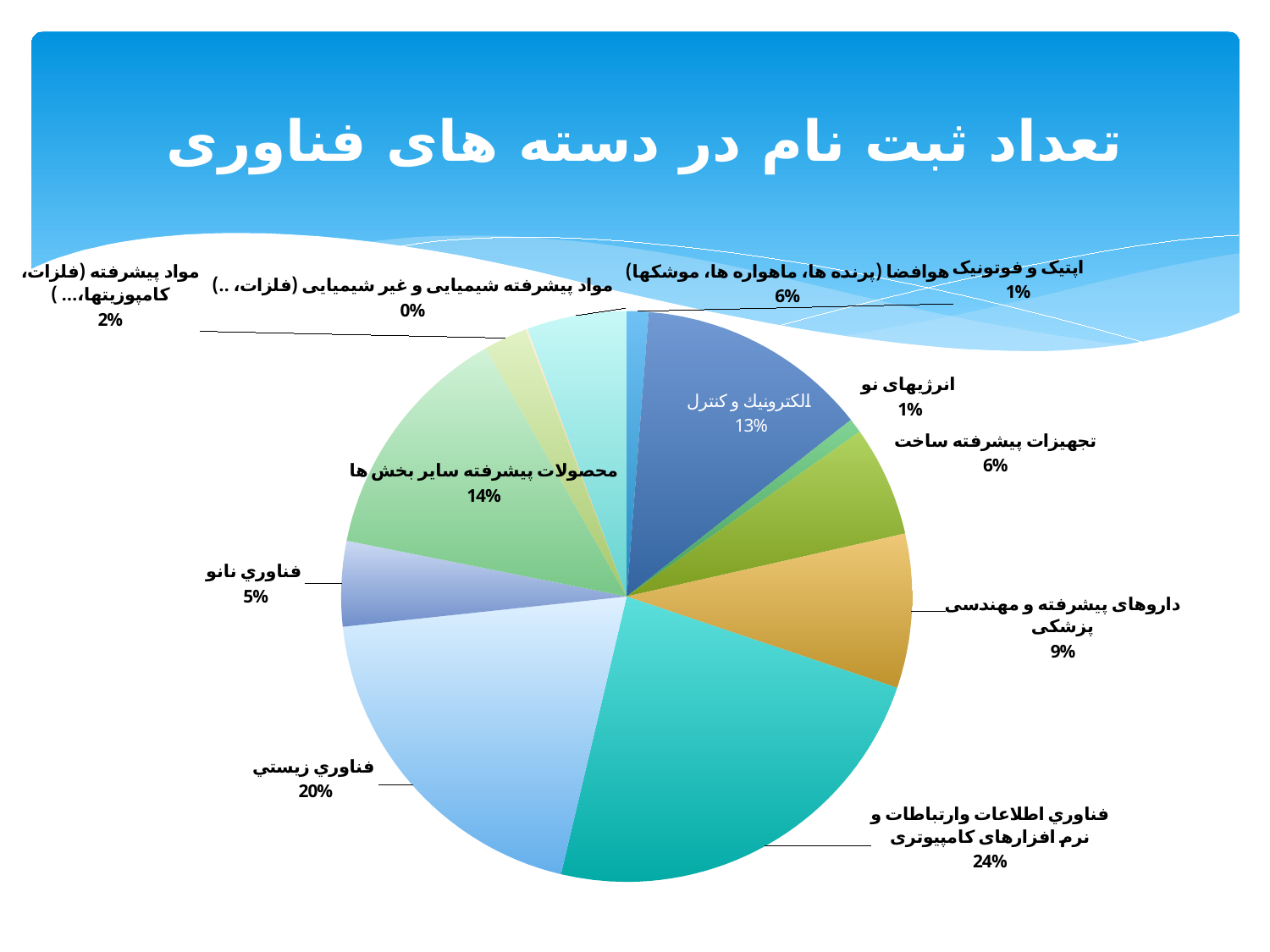
Which category has the smallest share of the pie? مواد پیشرفته شیمیایی و غیر شیمیایی (فلزات، ..) What is the difference in percentage points between فناوري زيستي and فناوري نانو? 15 What is the title of the chart? تعداد ثبت نام در دسته های فناوری What percentage is shown for تجهیزات پیشرفته ساخت? 6% Which category has the largest share of the pie? فناوری اطلاعات وارتباطات و نرم افزارهای کامپیوتری What share of the pie does فناوري زيستي have? 20% Which is larger, the share for محصولات پیشرفته سایر بخش ها or the share for هوافضا (پرنده ها، ماهواره ها، موشکها)? محصولات پیشرفته سایر بخش ها How many categories are shown in the pie chart? 12 What percentage is shown for الکترونیک و کنترل? 13% What percentage is shown for داروهای پیشرفته و مهندسی پزشکی? 9% What kind of chart is shown on the slide? pie chart What percentage is shown for انرژیهای نو? 1%